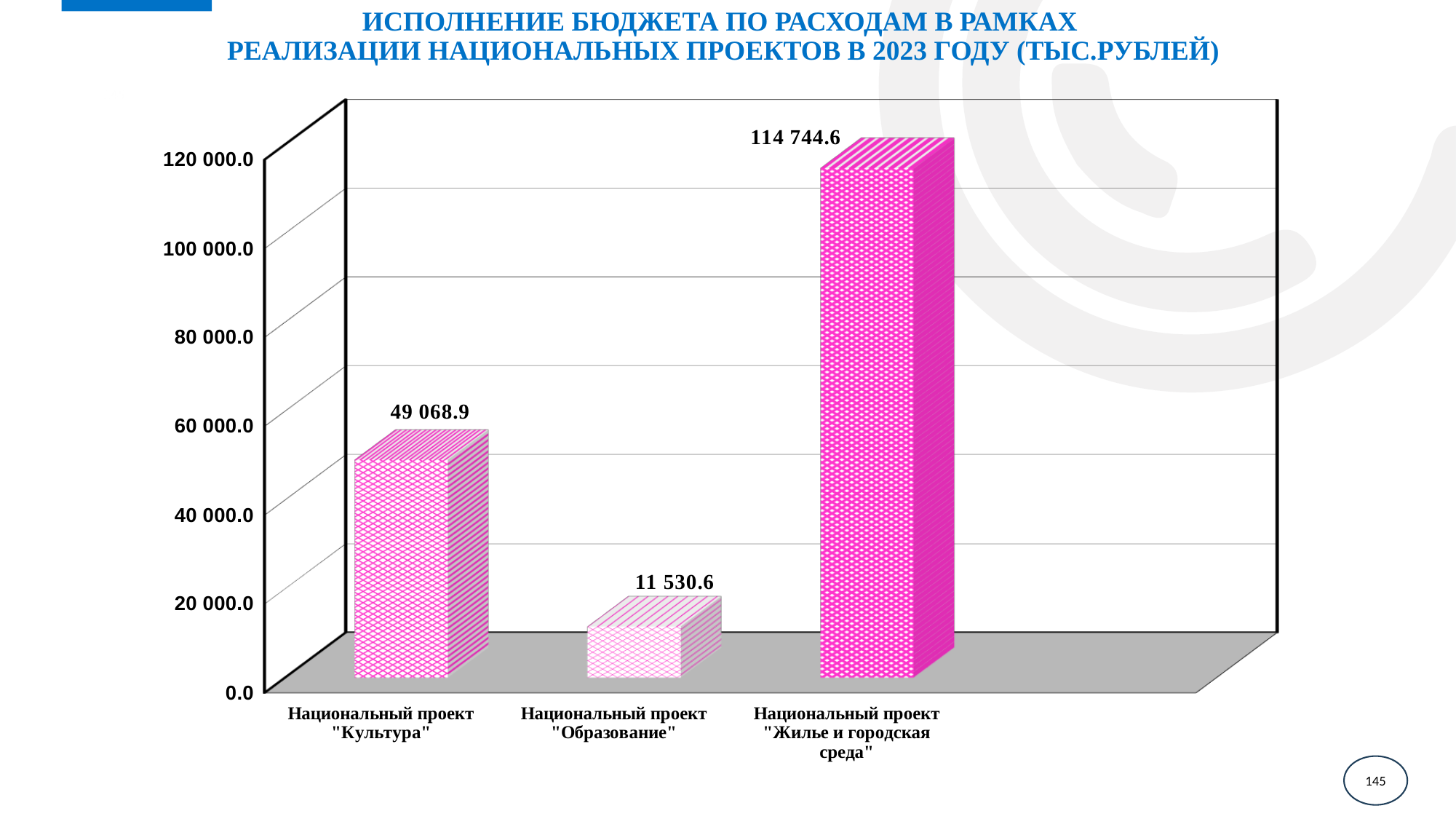
What is the value for Национальный проект "Жилье и городская среда"? 114 744.6 How many national projects are shown on the chart? 3 What is the value for Национальный проект "Образование"? 11 530.6 What is the difference between the values for "Культура" and "Образование"? 37 538.3 Which is larger: the value for "Культура" or the value for "Образование"? Национальный проект "Культура" Is the value for Национальный проект "Жилье и городская среда" greater or less than 100 000.0? greater In what units are the values on the chart expressed, according to the title? тыс. рублей Which national project has the highest budget execution value? Национальный проект "Жилье и городская среда" Which national project has the lowest budget execution value? Национальный проект "Образование" What is the value for Национальный проект "Культура"? 49 068.9 What kind of chart is shown on the slide? bar chart What is the difference between the values for "Жилье и городская среда" and "Культура"? 65 675.7